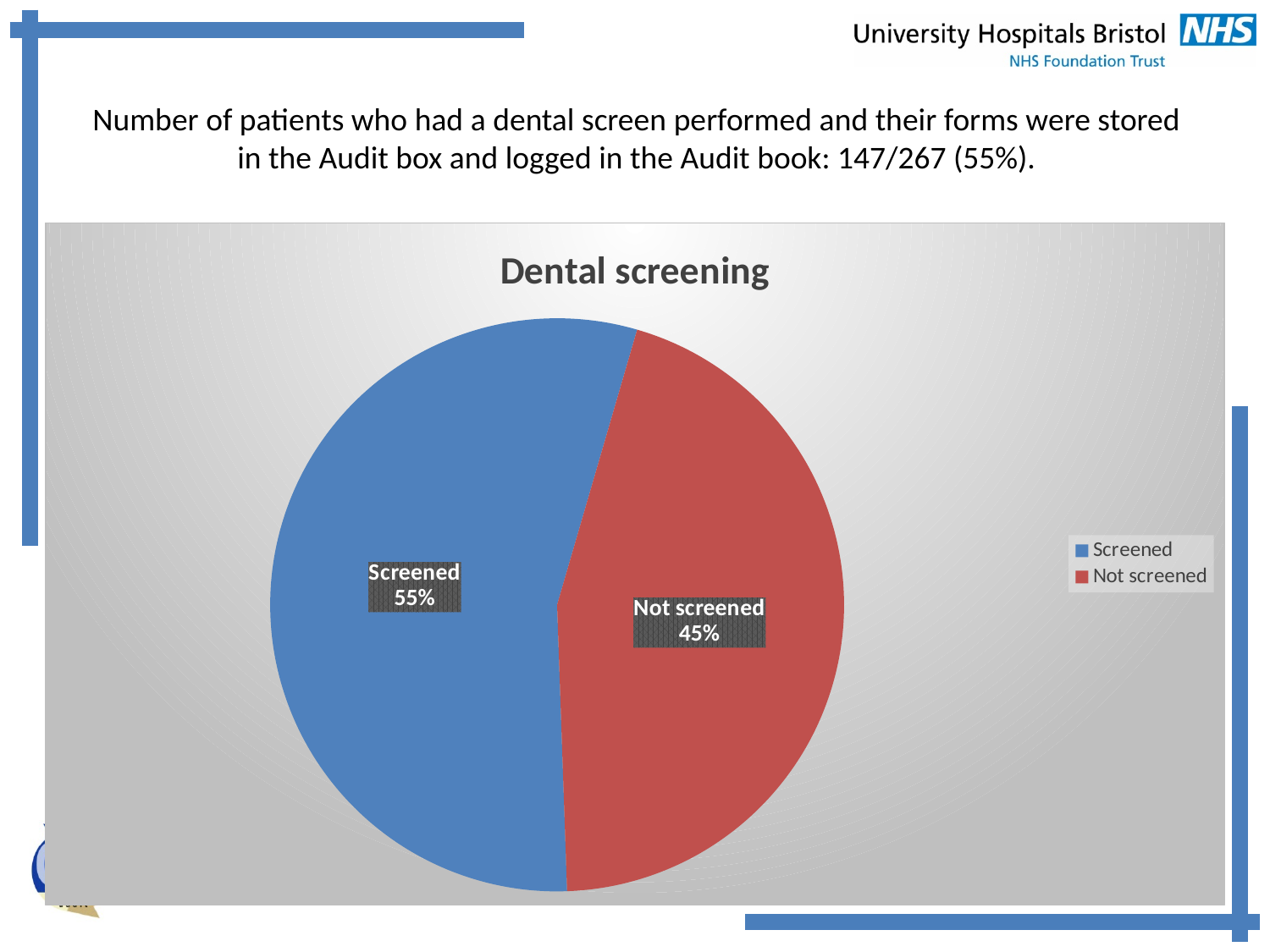
Which slice of the pie is the largest? Screened What share of the pie does the Screened slice take? 55% How many entries does the legend list? 2 What is the title of the chart? Dental screening Which is larger, the Screened slice or the Not screened slice? Screened Which slice of the pie is the smallest? Not screened How many slices does the pie chart have? 2 What percentage of the pie is labelled Not screened? 45% What percentage of the pie is labelled Screened? 55% What kind of chart is shown on the slide? pie chart What is the difference in percentage points between the Screened and Not screened slices? 10 What colour is the Not screened slice? red